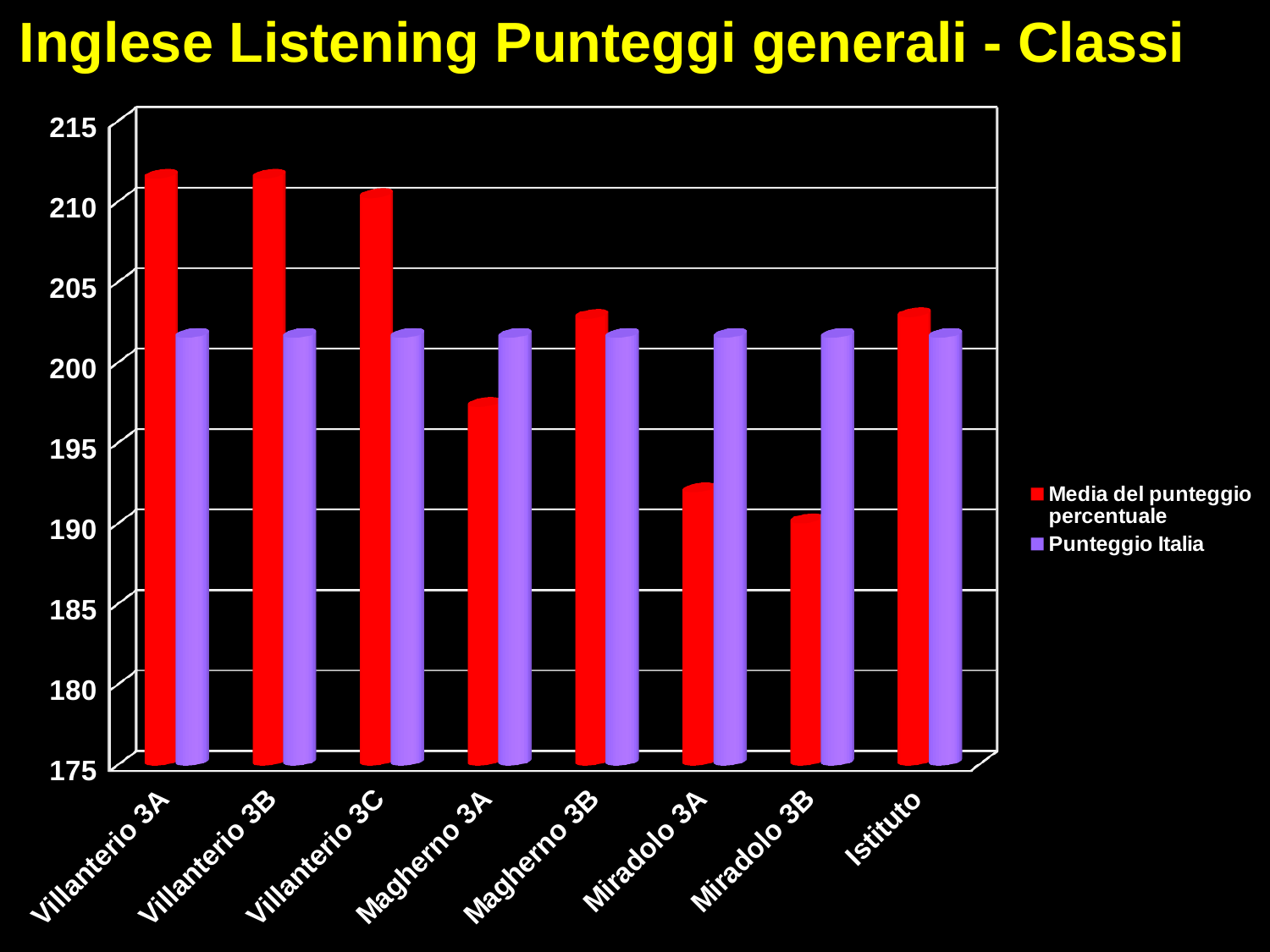
Which colour represents Punteggio Italia in the legend? Purple Which category has the lowest value for Media del punteggio percentuale? Miradolo 3B What kind of chart is shown on the slide? Bar chart Is the Media del punteggio percentuale value for Miradolo 3B greater or less than 195? less How many series does the legend list? 2 Is the Media del punteggio percentuale value for Magherno 3A greater or less than 200? less Is the Media del punteggio percentuale value for Villanterio 3A greater or less than 210? greater What is the title of the chart? Inglese Listening Punteggi generali - Classi For Magherno 3A, which is larger: Media del punteggio percentuale or Punteggio Italia? Punteggio Italia Which is larger: the Media del punteggio percentuale for Villanterio 3C or for Miradolo 3B? Villanterio 3C How many categories are shown on the x axis? 8